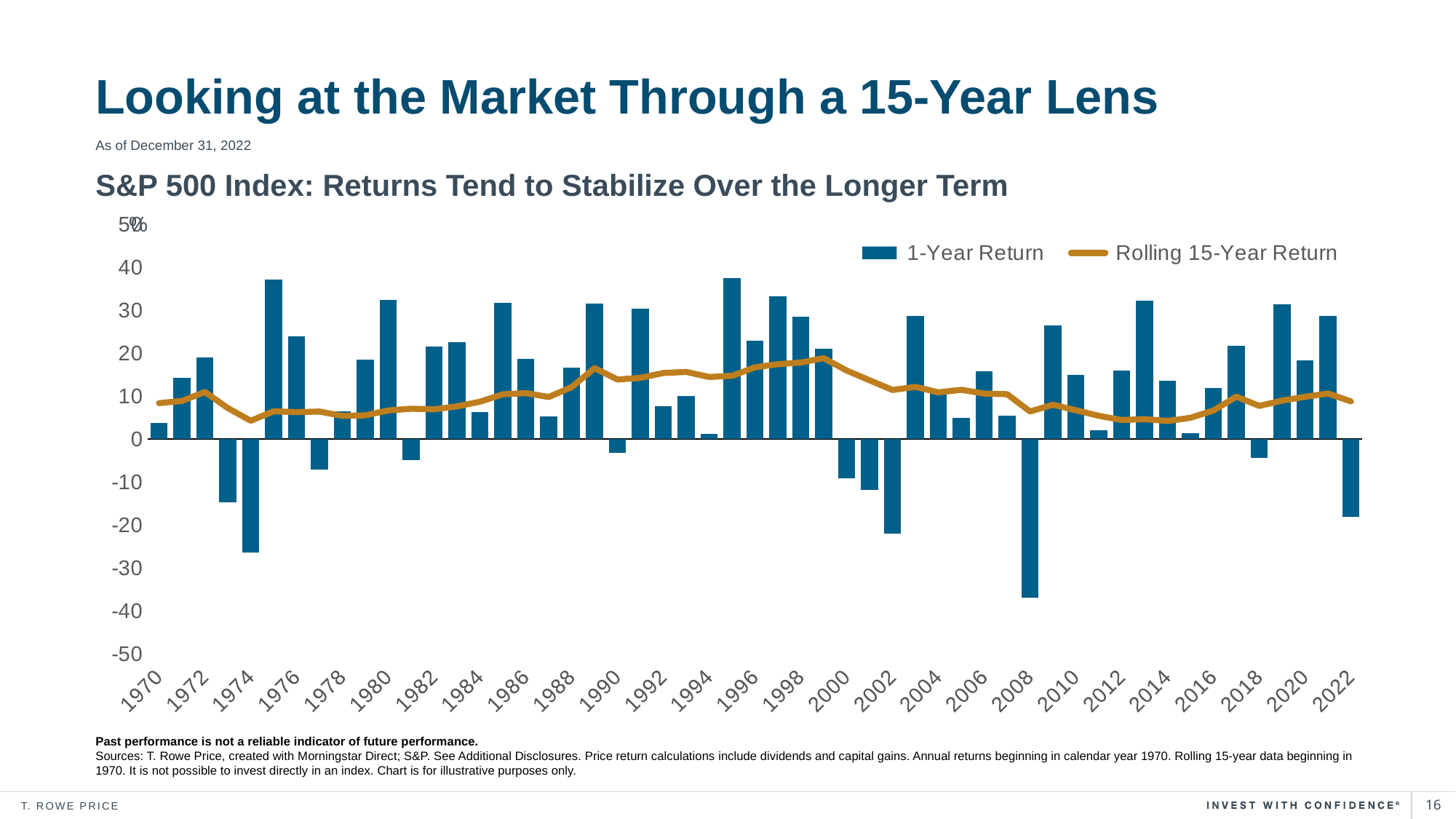
Which series is drawn as a line rather than bars? Rolling 15-Year Return Is the 1-Year Return for 2022 greater or less than -10? less Is the 1-Year Return for 1995 greater or less than 30? greater Is the 1-Year Return for 2008 greater or less than -30? less What kind of chart is shown on the slide? A combined bar and line chart Which year has the lowest 1-Year Return bar? 2008 Does the Rolling 15-Year Return line rise or fall between 1999 and 2008? fall Which year has the larger 1-Year Return, 1975 or 1977? 1975 What is the first year shown on the x axis? 1970 How many series does the legend list? 2